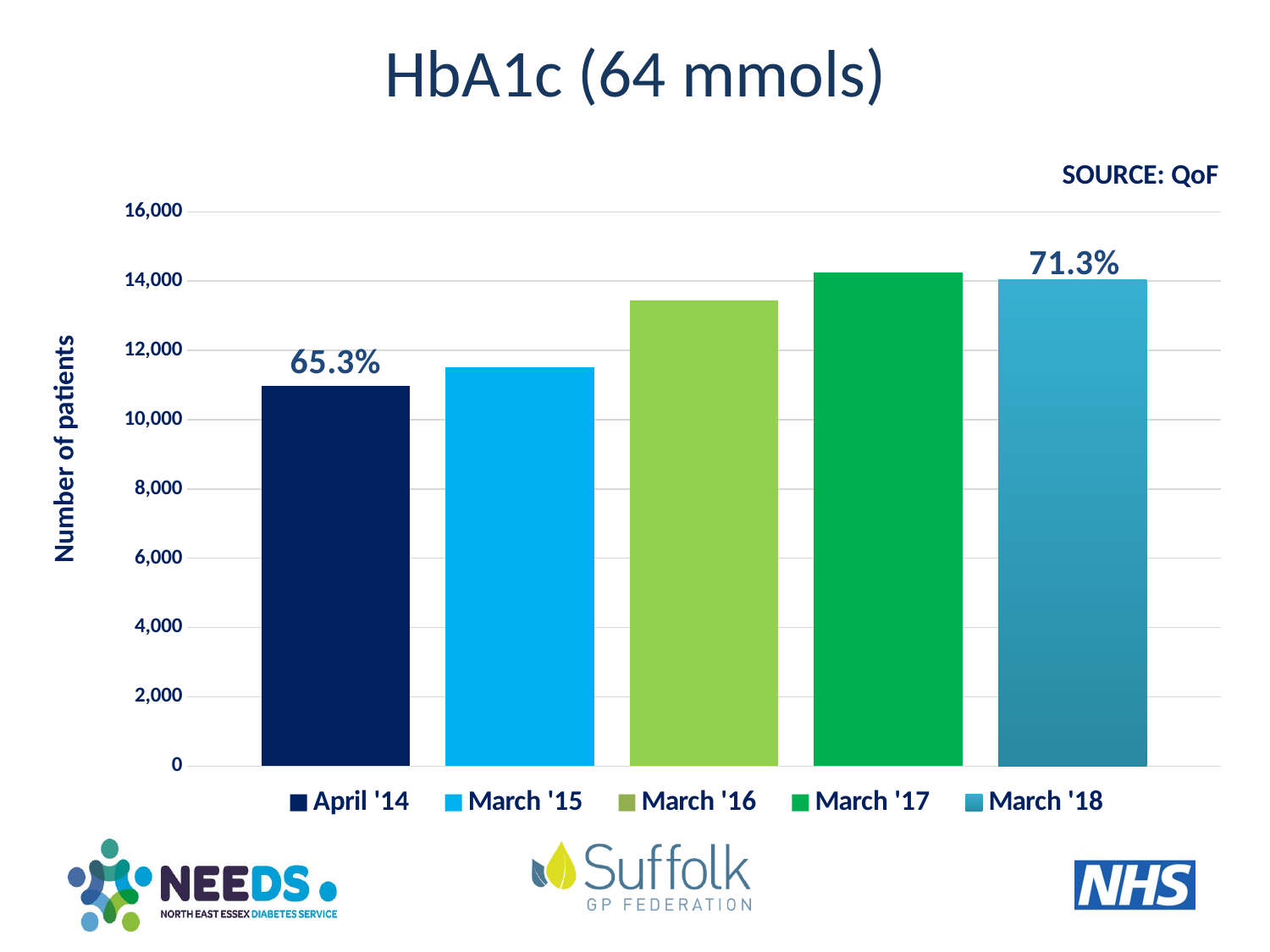
What percentage label is shown above the April '14 bar? 65.3% What kind of chart is shown on the slide? Bar chart Which time period has the lowest number of patients? April '14 Do the values generally rise or fall from April '14 to March '18? Rise Is the value for March '16 greater or less than 12,000? greater What is the title of the vertical axis? Number of patients How many entries does the legend list? 5 Is the value for April '14 greater or less than 12,000? less What percentage label is shown above the March '18 bar? 71.3% How many bars (time periods) are plotted in the chart? 5 Is the value for March '17 greater or less than 14,000? greater Which is larger, the value for March '15 or the value for March '16? March '16